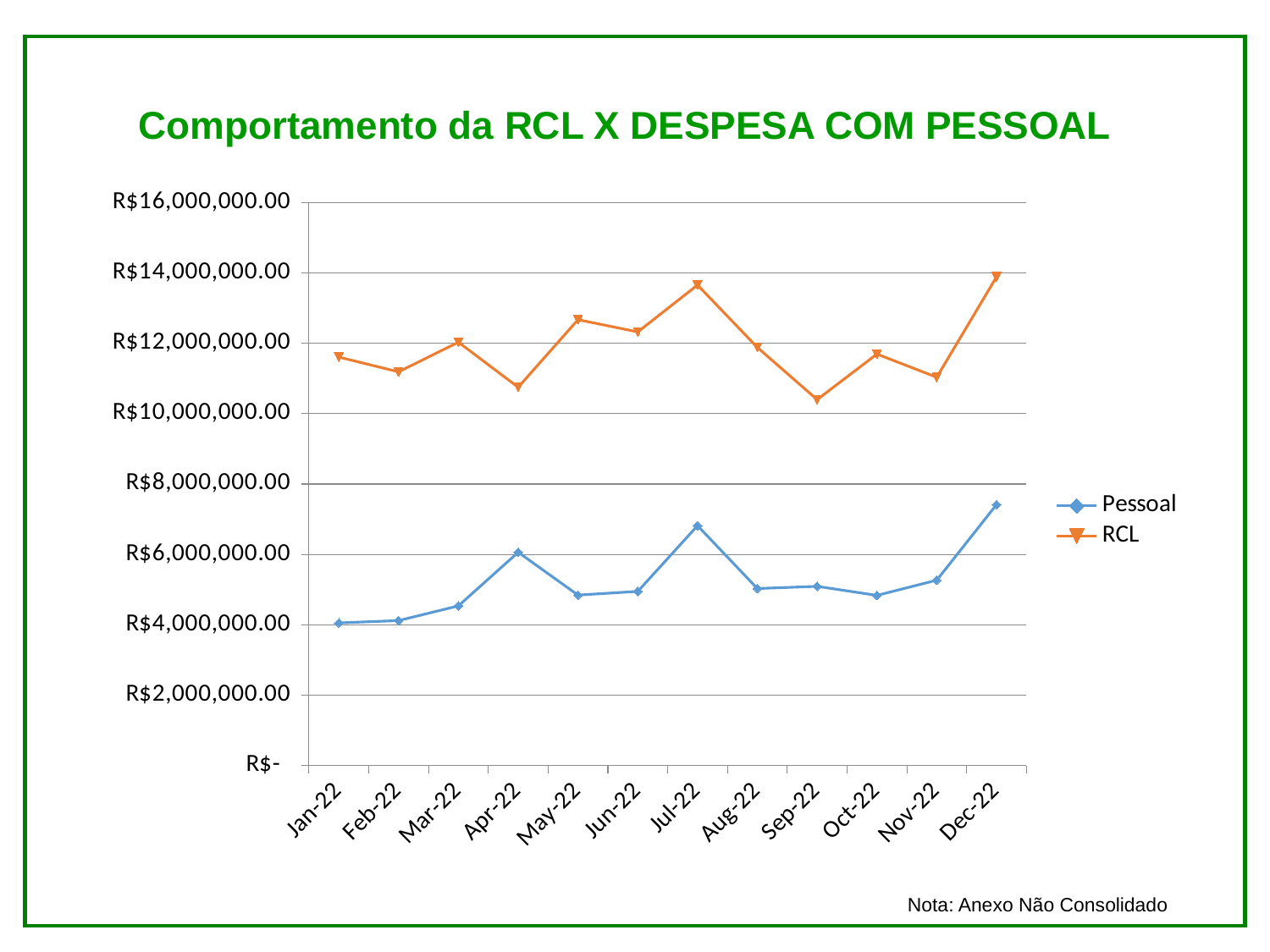
Which series has the higher value in Jul-22, Pessoal or RCL? RCL Is the value for RCL in Sep-22 greater or less than R$12,000,000.00? less How many series does the legend list? 2 What kind of chart is shown on the slide? Line chart Which is larger for Pessoal, the value in Apr-22 or the value in Mar-22? Apr-22 How many months are plotted along the x axis? 12 Does the Pessoal series rise or fall from Jan-22 to Apr-22? Rise What is the title of the chart? Comportamento da RCL X DESPESA COM PESSOAL Is the value for Pessoal in Jan-22 greater or less than R$6,000,000.00? less Is the value for RCL in Jul-22 greater or less than R$12,000,000.00? greater In which month does the Pessoal series reach its highest value? Dec-22